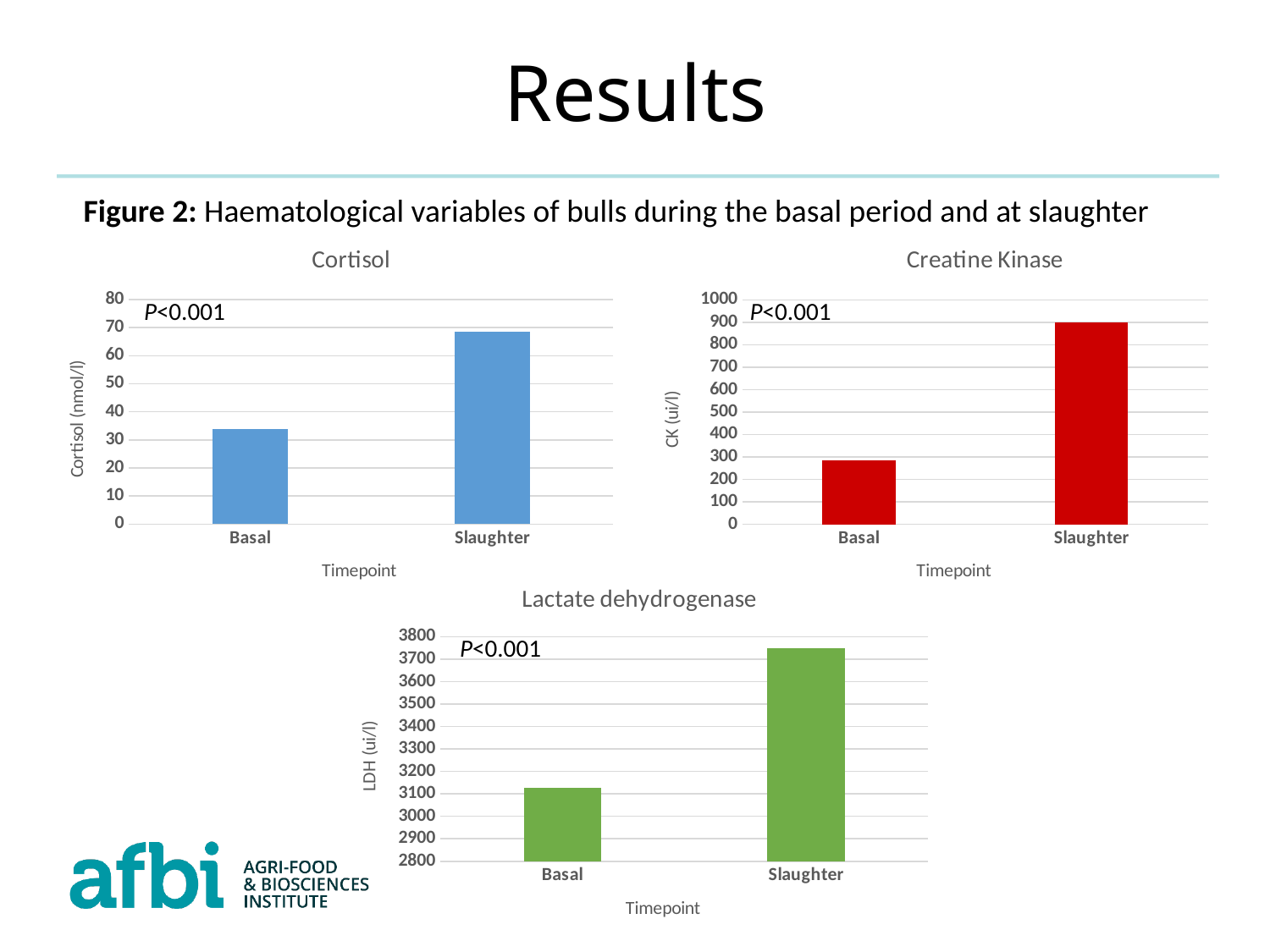
How many timepoints are plotted in the Cortisol chart? 2 In the Lactate dehydrogenase chart, is the value for Basal greater or less than 3200? less What is the y-axis label of the Lactate dehydrogenase chart? LDH (ui/l) What kind of chart is the Creatine Kinase chart? bar chart In the Cortisol chart, which timepoint has the higher value? Slaughter In the Creatine Kinase chart, which timepoint has the lower value? Basal In the Lactate dehydrogenase chart, is the Basal value larger or smaller than the Slaughter value? smaller In the Lactate dehydrogenase chart, is the value for Slaughter greater or less than 3600? greater In the Creatine Kinase chart, is the value for Slaughter greater or less than 800? greater